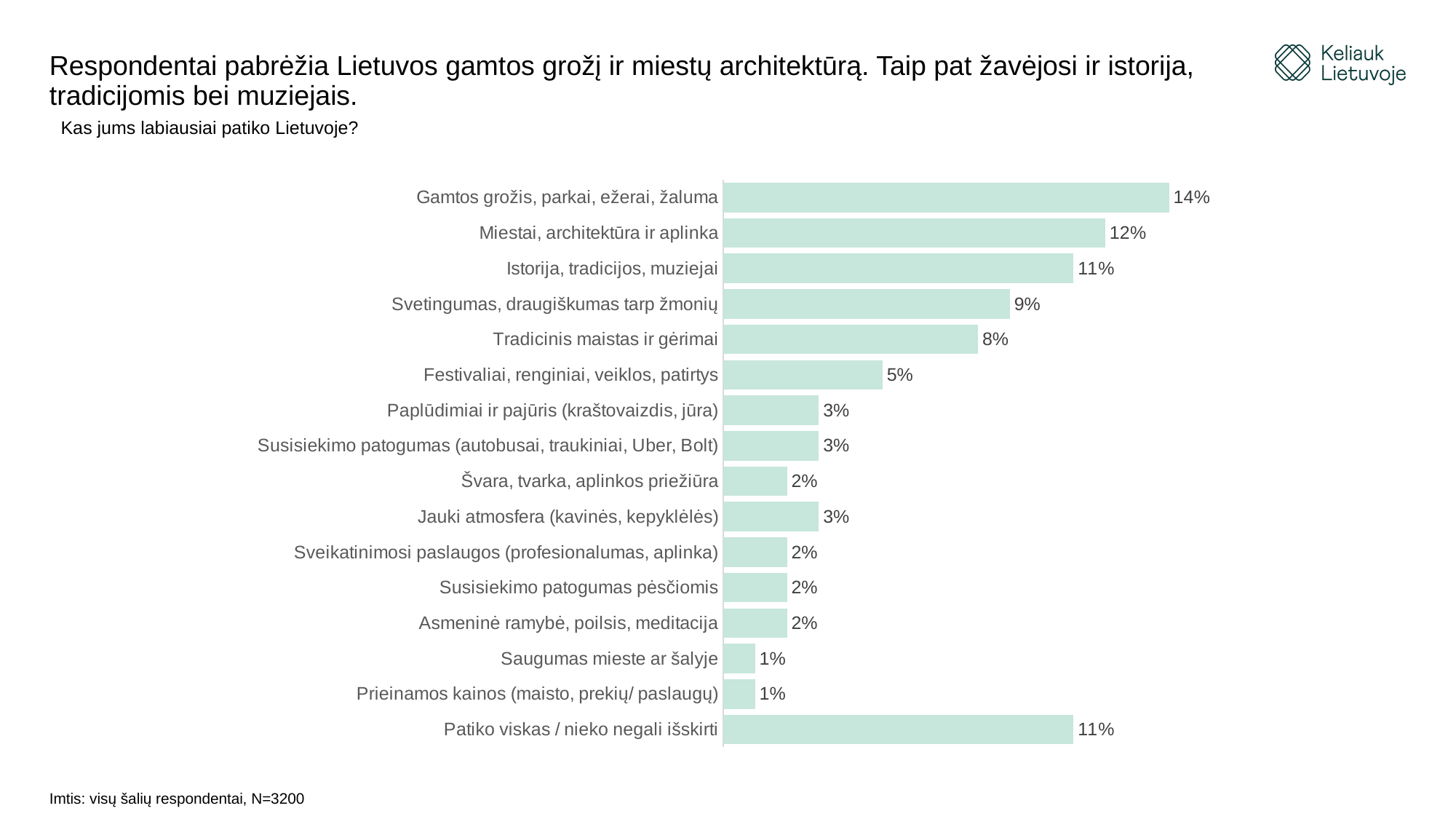
Which is larger: "Svetingumas, draugiškumas tarp žmonių" or "Festivaliai, renginiai, veiklos, patirtys"? Svetingumas, draugiškumas tarp žmonių What kind of chart is shown on the slide? Bar chart What is the difference between "Gamtos grožis, parkai, ežerai, žaluma" and "Istorija, tradicijos, muziejai"? 3% What is the value for "Patiko viskas / nieko negali išskirti"? 11% What is the difference between "Miestai, architektūra ir aplinka" and "Tradicinis maistas ir gėrimai"? 4% What percentage of respondents chose "Gamtos grožis, parkai, ežerai, žaluma"? 14% What is the value for "Svetingumas, draugiškumas tarp žmonių"? 9% How many categories are shown in the chart? 16 What is the value for "Festivaliai, renginiai, veiklos, patirtys"? 5% Which category has the highest value? Gamtos grožis, parkai, ežerai, žaluma Which is larger: "Jauki atmosfera (kavinės, kepyklėlės)" or "Saugumas mieste ar šalyje"? Jauki atmosfera (kavinės, kepyklėlės) What question is the chart based on, as shown above the chart? Kas jums labiausiai patiko Lietuvoje?